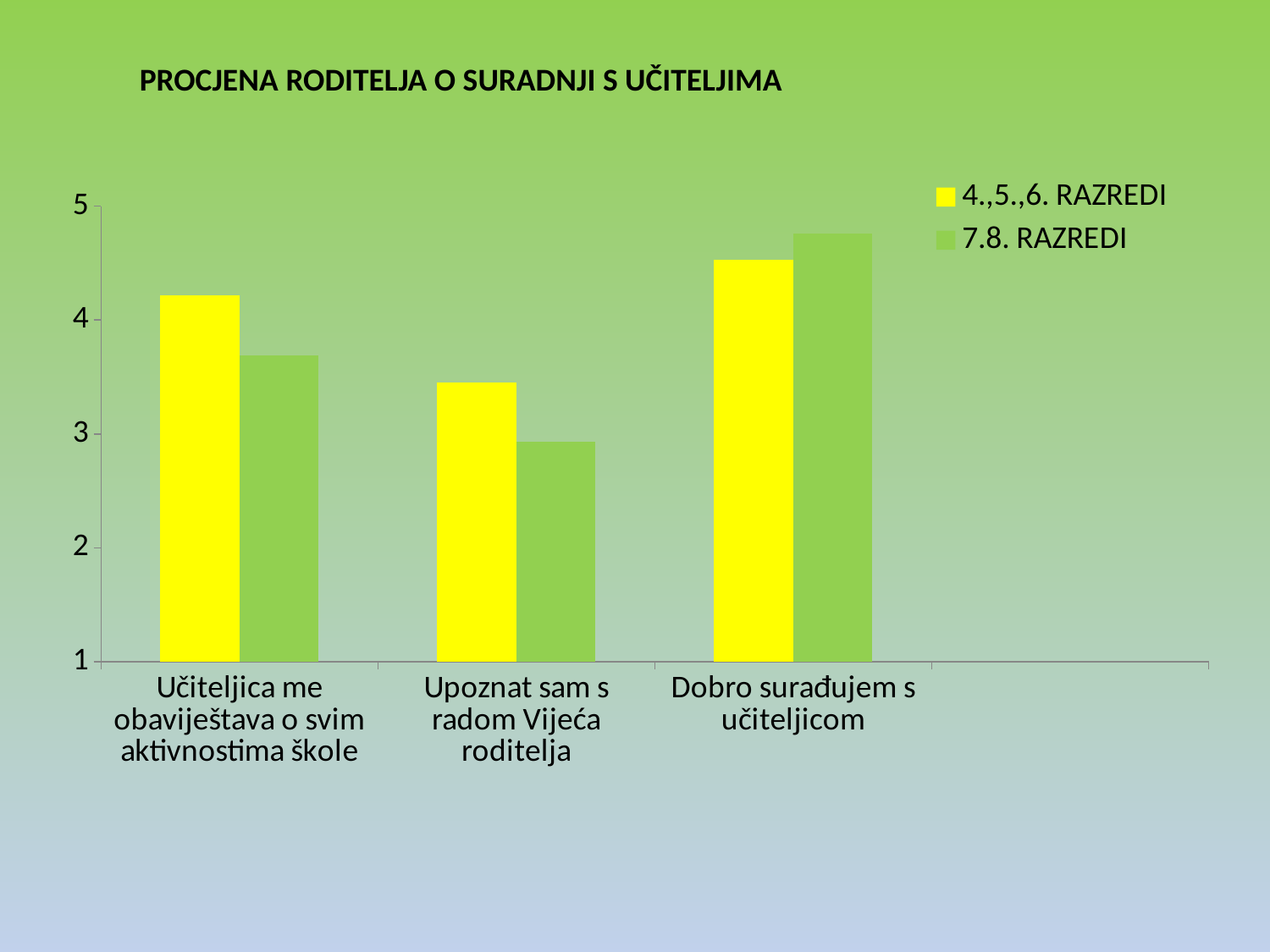
What kind of chart is shown on the slide? bar chart Which series is shown in yellow? 4.,5.,6. RAZREDI Which category has the lowest value for the 4.,5.,6. RAZREDI series? Upoznat sam s radom Vijeća roditelja For 'Dobro surađujem s učiteljicom', which series has the larger value, 4.,5.,6. RAZREDI or 7.8. RAZREDI? 7.8. RAZREDI What is the title of the chart? PROCJENA RODITELJA O SURADNJI S UČITELJIMA Is the value for 4.,5.,6. RAZREDI in 'Dobro surađujem s učiteljicom' greater or less than 4? greater Which category has the lowest value for the 7.8. RAZREDI series? Upoznat sam s radom Vijeća roditelja For 'Učiteljica me obavještava o svim aktivnostima škole', which series has the larger value, 4.,5.,6. RAZREDI or 7.8. RAZREDI? 4.,5.,6. RAZREDI How many series does the legend list? 2 Which category has the highest value for the 7.8. RAZREDI series? Dobro surađujem s učiteljicom How many categories are shown on the x axis? 3